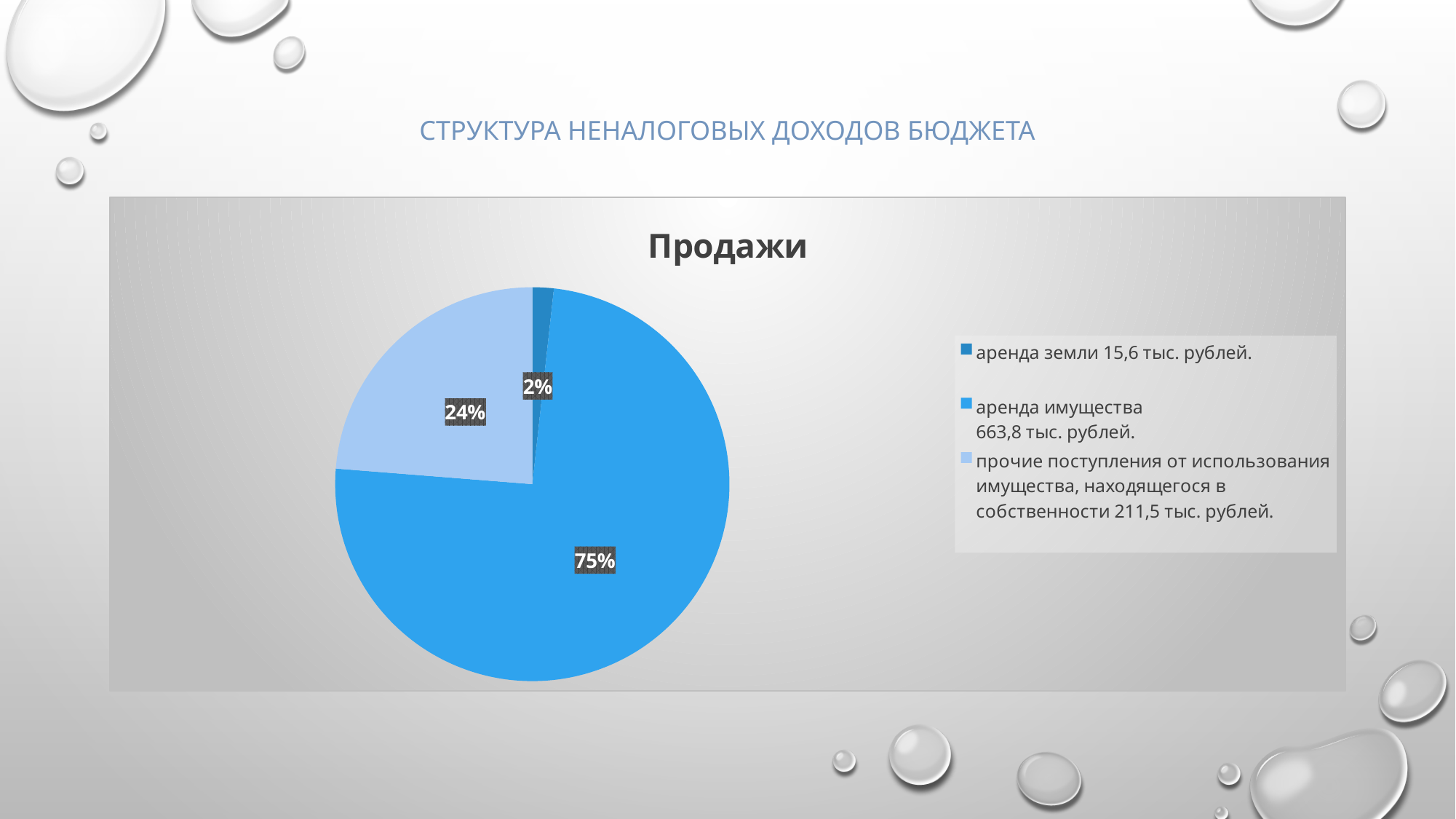
What amount in thousand rubles is listed in the legend for "аренда земли"? 15,6 тыс. рублей What is the title of the chart? Продажи What share of the pie does "прочие поступления от использования имущества, находящегося в собственности" represent? 24% What type of chart is shown on the slide? pie chart What is the difference in percentage points between the "аренда имущества" slice and the "прочие поступления" slice? 51% Which is larger: the slice for "прочие поступления от использования имущества" or the slice for "аренда земли"? прочие поступления от использования имущества How many slices does the pie chart have? 3 What share of the pie does "аренда имущества" represent? 75% What amount in thousand rubles is listed in the legend for "аренда имущества"? 663,8 тыс. рублей What share of the pie does "аренда земли" represent? 2% Which category has the smallest slice of the pie? аренда земли Which category has the largest slice of the pie? аренда имущества